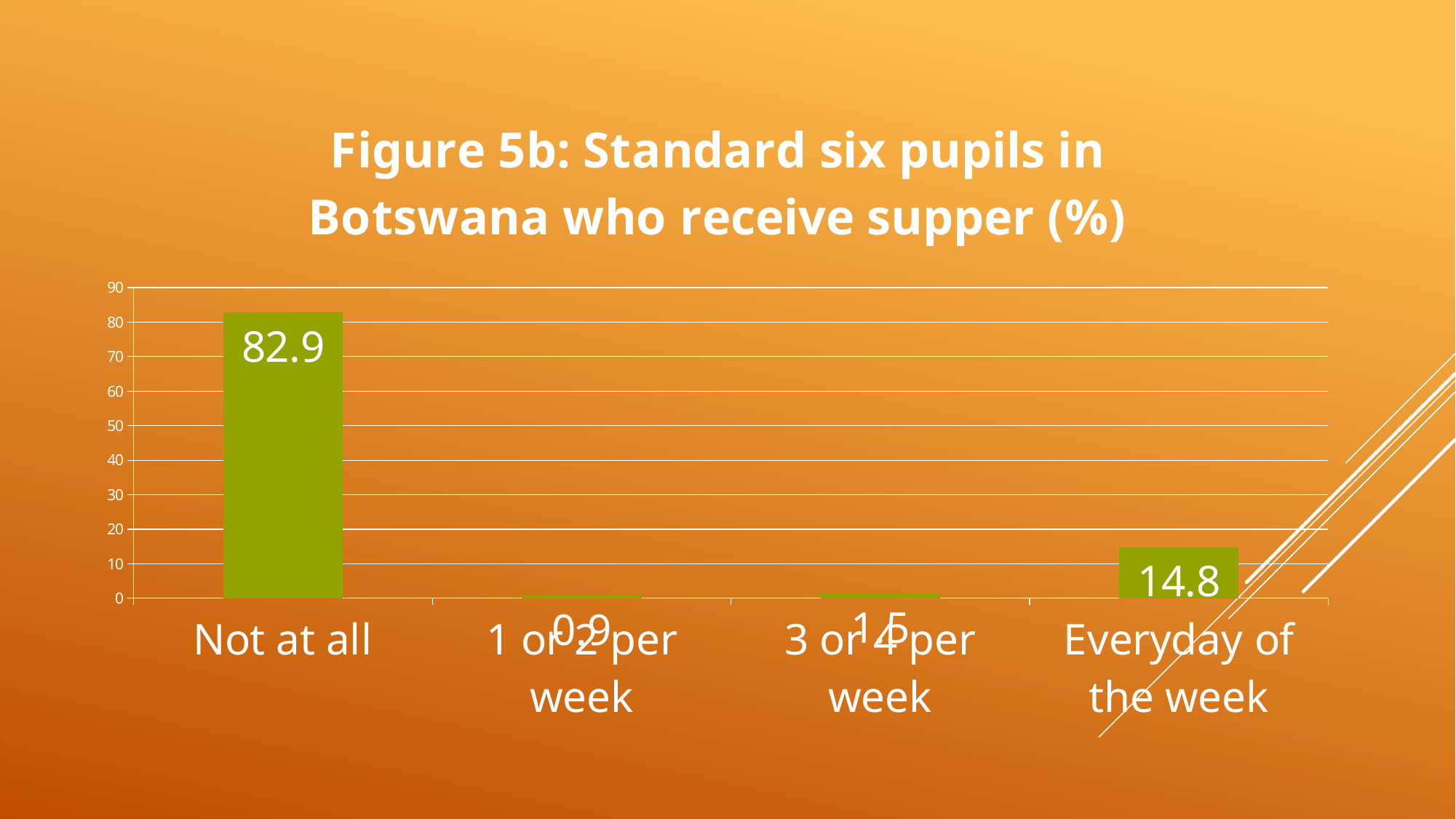
Is the value for "Not at all" greater or less than 80? greater What is the value for "Everyday of the week"? 14.8 Which category has the highest value? Not at all What is the difference between the values for "Not at all" and "Everyday of the week"? 68.1 Which category has the lowest value? 1 or 2 per week Which is larger, the value for "3 or 4 per week" or the value for "1 or 2 per week"? 3 or 4 per week What is the value for "Not at all"? 82.9 What kind of chart is shown on the slide? bar chart How many categories are shown on the x axis? 4 What is the title of the chart? Figure 5b: Standard six pupils in Botswana who receive supper (%) What is the value for "3 or 4 per week"? 1.5 What is the value for "1 or 2 per week"? 0.9